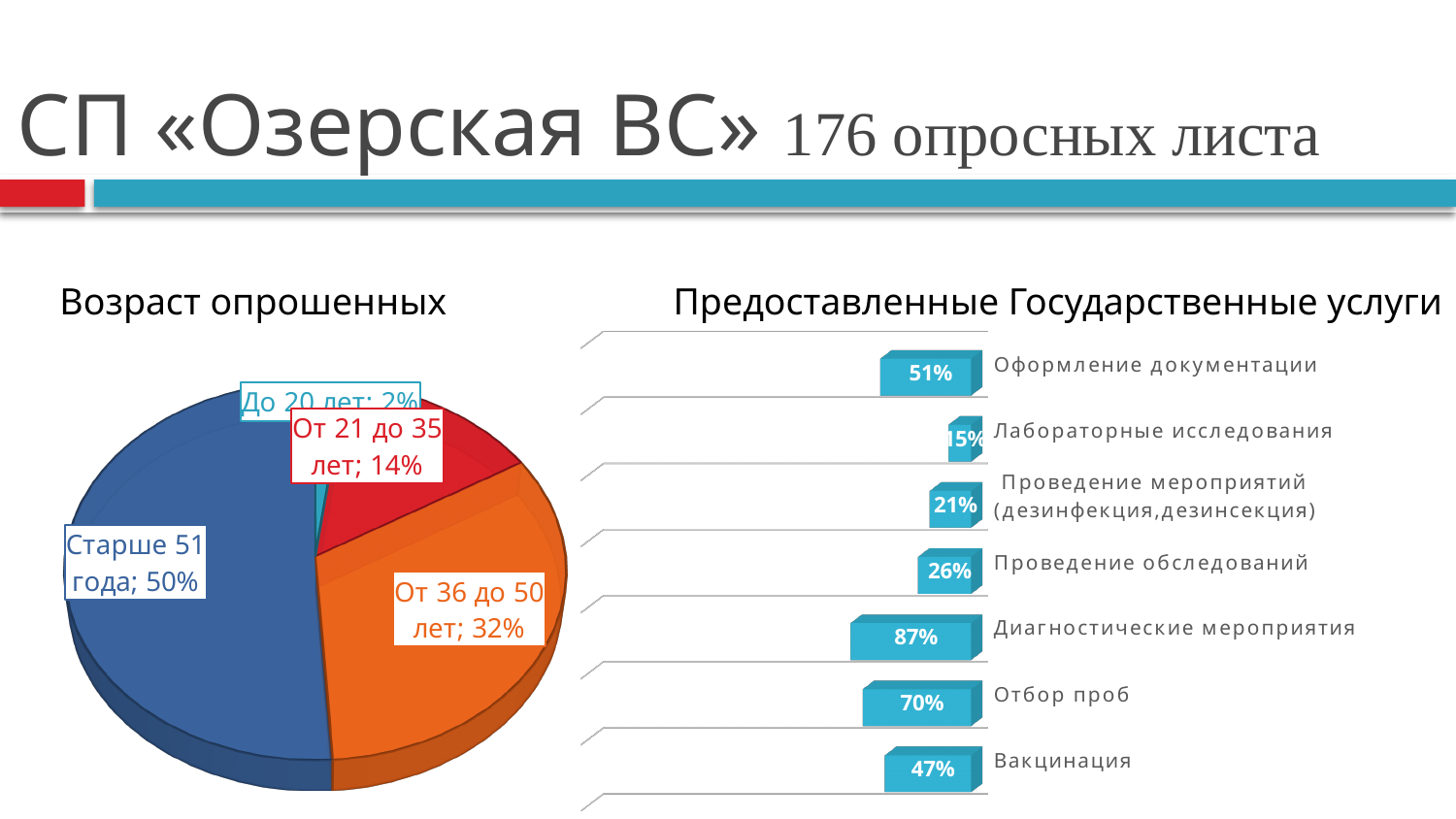
In the chart 'Предоставленные Государственные услуги', what is the value for 'Отбор проб'? 70% In the chart 'Предоставленные Государственные услуги', what is the value for 'Диагностические мероприятия'? 87% In the chart 'Предоставленные Государственные услуги', which service has the lowest value? Лабораторные исследования In the chart 'Возраст опрошенных', what is the difference between the shares of 'От 36 до 50 лет' and 'От 21 до 35 лет'? 18% In the chart 'Предоставленные Государственные услуги', how many services are listed? 7 In the chart 'Возраст опрошенных', which age group has the smallest share? До 20 лет In the chart 'Предоставленные Государственные услуги', which is larger: 'Оформление документации' or 'Вакцинация'? Оформление документации In the chart 'Предоставленные Государственные услуги', which service has the highest value? Диагностические мероприятия In the chart 'Возраст опрошенных', what share of respondents are 'Старше 51 года'? 50% What kind of chart is 'Возраст опрошенных'? Pie chart In the chart 'Возраст опрошенных', how many slices does the pie have? 4 In the chart 'Возраст опрошенных', what share of respondents are 'От 36 до 50 лет'? 32%